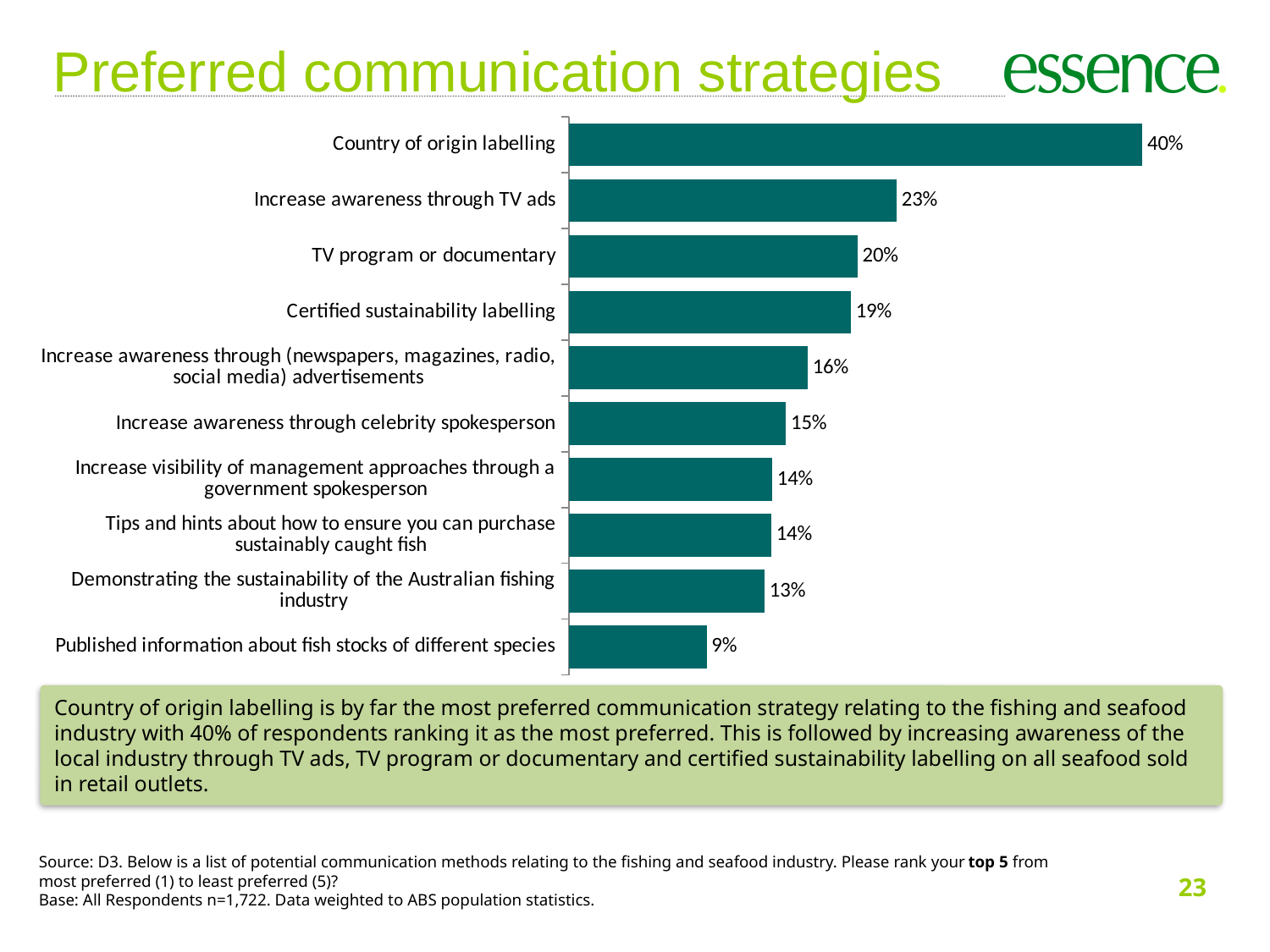
What kind of chart is shown on the slide? Bar chart What is the difference between the values for Country of origin labelling and Increase awareness through TV ads? 17% What is the value for Increase awareness through TV ads? 23% Do the values rise or fall going from the top bar to the bottom bar? Fall What is the title of the slide? Preferred communication strategies How many categories are shown in the chart? 10 What is the value for Certified sustainability labelling? 19% Which category has the lowest value? Published information about fish stocks of different species Which category has the highest value? Country of origin labelling What is the value for Published information about fish stocks of different species? 9% What is the value for Country of origin labelling? 40% Which is larger, the value for TV program or documentary or the value for Increase awareness through celebrity spokesperson? TV program or documentary